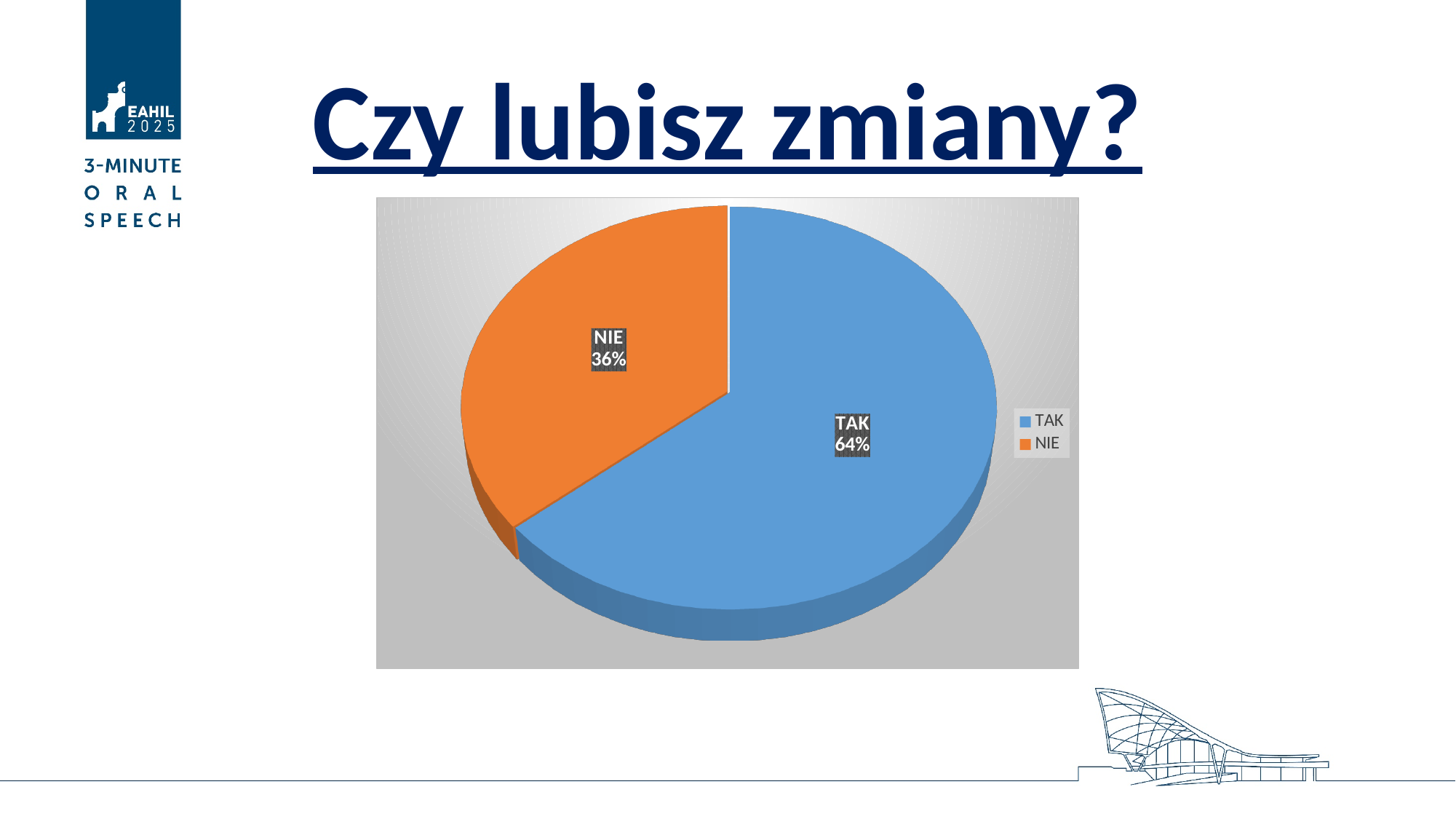
How many entries does the legend list? 2 What kind of chart is shown on the slide? Pie chart What is the title of the slide above the chart? Czy lubisz zmiany? What colour is the NIE slice? Orange Which slice is the largest in the pie chart? TAK What share of the pie does TAK represent? 64% What is the difference in percentage points between TAK and NIE? 28 Which slice is the smallest in the pie chart? NIE What share of the pie does NIE represent? 36% How many slices does the pie chart have? 2 Which is larger, the TAK slice or the NIE slice? TAK